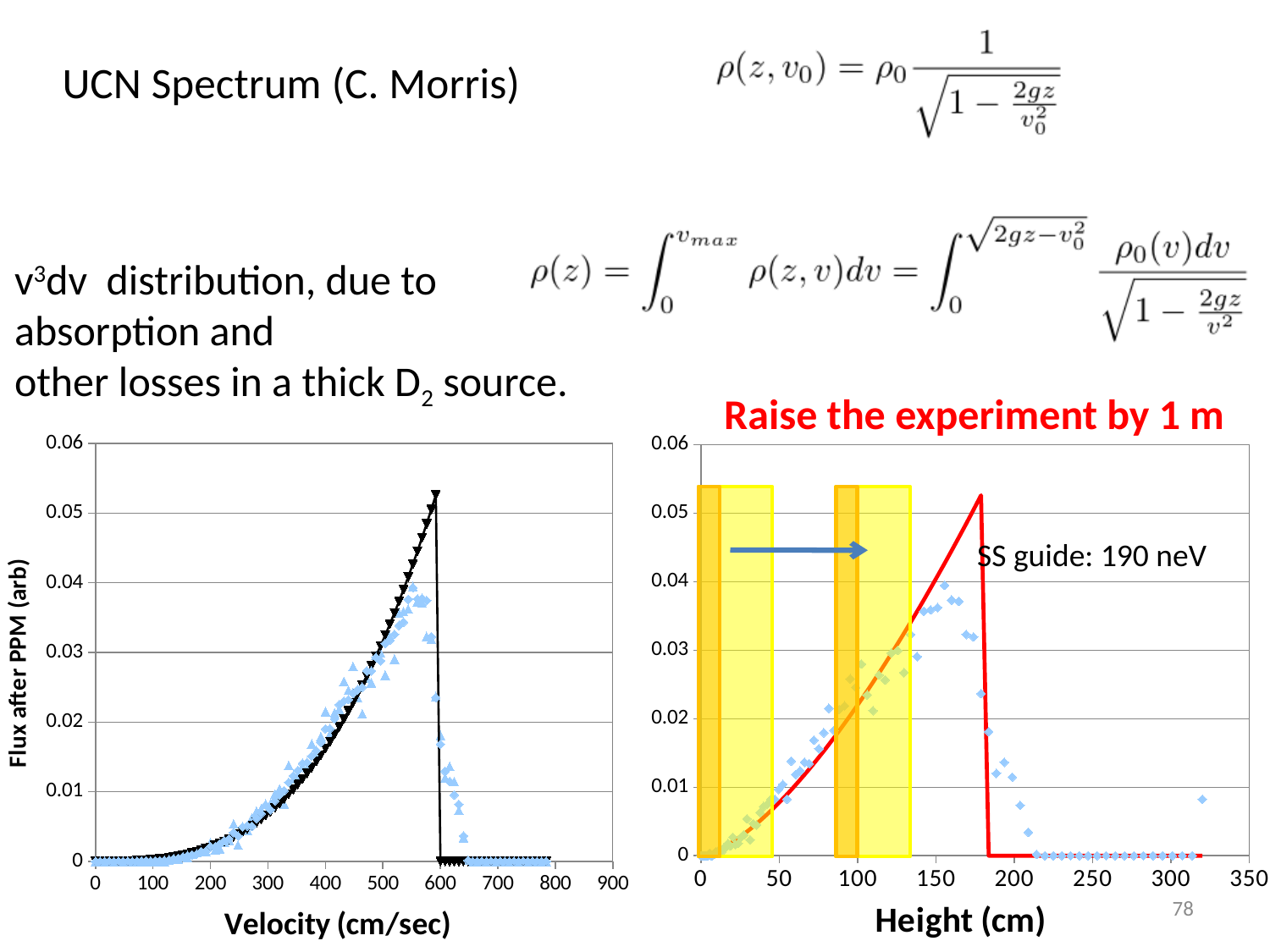
In the right chart, is the value of the red line at a height of 100 cm greater or less than 0.02? greater In the right chart, is the value of the red line at a height of 250 cm greater or less than 0.01? less In the left chart, is the peak value of the black triangle series greater or less than 0.04? greater In the left chart, what is the label of the x axis? Velocity (cm/sec) In the left chart, do the values of the black triangle series rise or fall as velocity increases from 0 to 500 cm/sec? rise In the left chart (Flux after PPM vs Velocity), what kind of chart is it? scatter chart In the right chart, what is the label of the x axis? Height (cm) How many charts are shown on the slide? 2